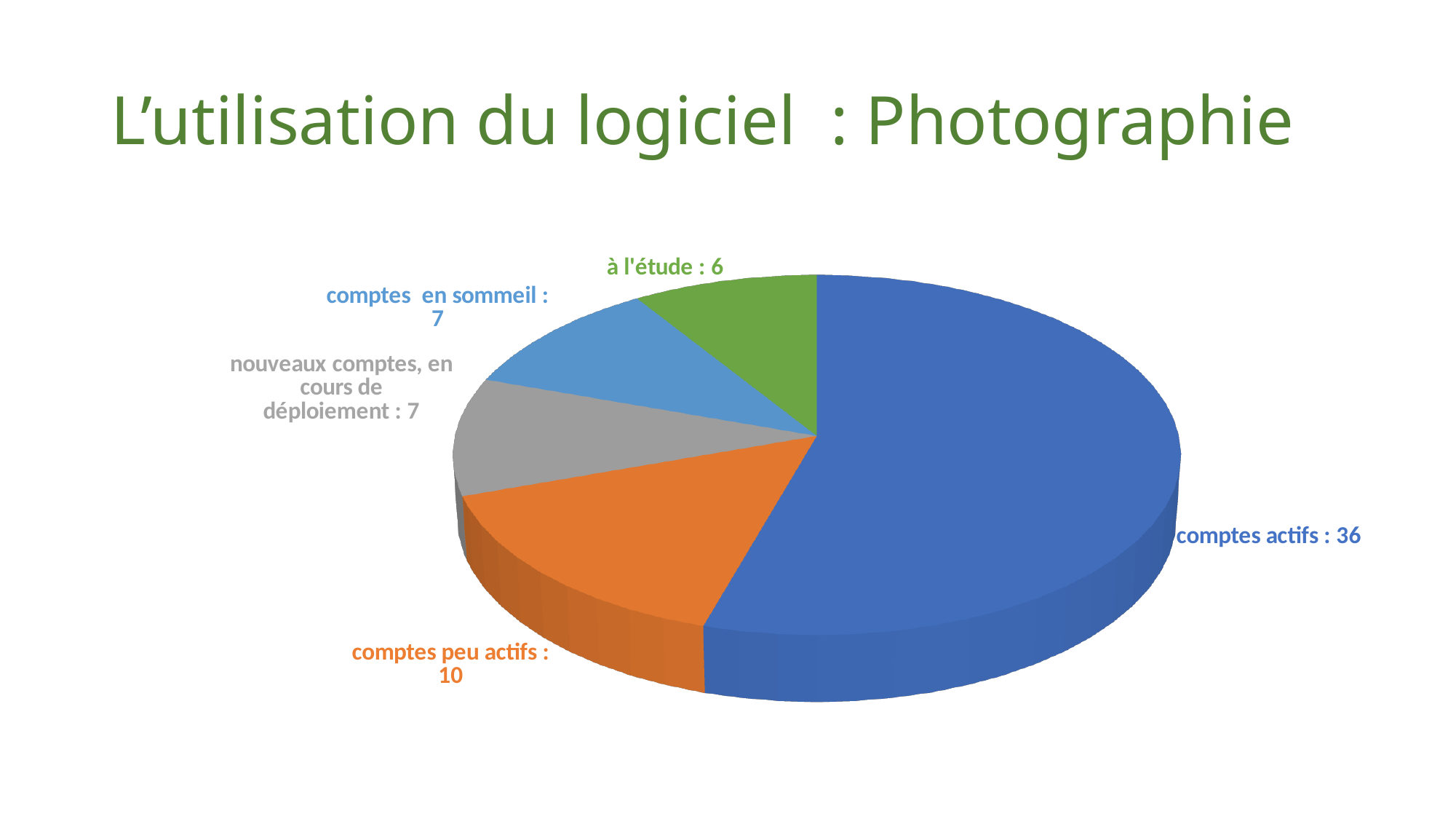
What is the value for "comptes en sommeil"? 7 Which category has the largest slice of the pie? comptes actifs How many categories are shown in the pie chart? 5 What is the value for "comptes actifs"? 36 What kind of chart is shown on the slide? pie chart What is the difference between the values for "comptes actifs" and "comptes peu actifs"? 26 What is the value for "à l'étude"? 6 What is the value for "comptes peu actifs"? 10 Which is larger, the value for "comptes peu actifs" or the value for "à l'étude"? comptes peu actifs Which category has the smallest slice of the pie? à l'étude What is the total of all the values shown in the pie chart? 66 What is the title of the slide? L'utilisation du logiciel : Photographie